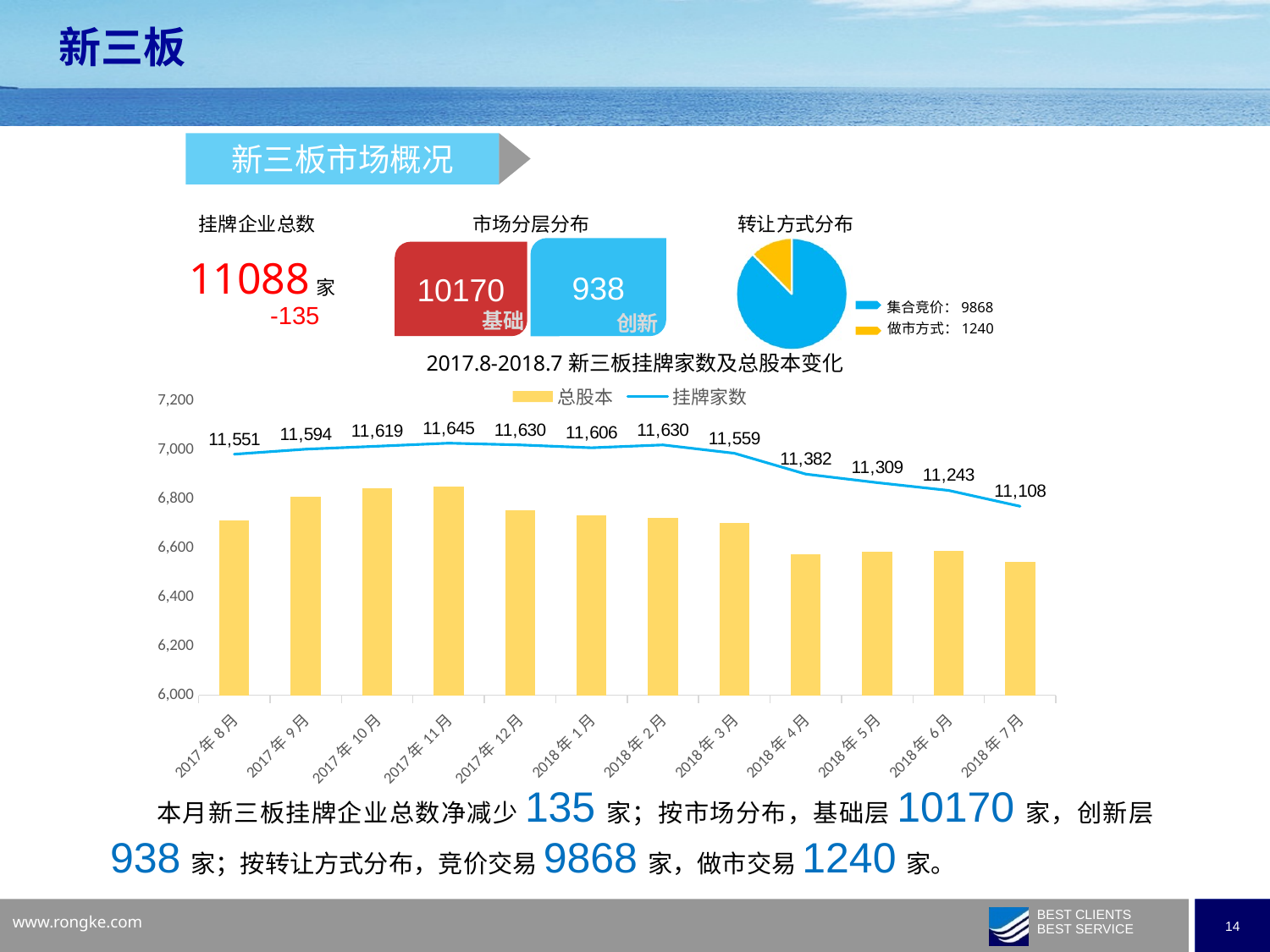
In the chart titled 2017.8-2018.7 新三板挂牌家数及总股本变化, is the 总股本 bar for 2017年11月 greater or less than 6,800? greater In the chart titled 2017.8-2018.7 新三板挂牌家数及总股本变化, how many months are shown on the x axis? 12 In the pie chart titled 转让方式分布, what is the value for 做市方式? 1240 In the chart titled 2017.8-2018.7 新三板挂牌家数及总股本变化, which month has the lowest 挂牌家数? 2018年7月 In the chart titled 2017.8-2018.7 新三板挂牌家数及总股本变化, does the 挂牌家数 line rise or fall from 2018年2月 to 2018年7月? fall In the chart titled 2017.8-2018.7 新三板挂牌家数及总股本变化, how many series does the legend list? 2 In the chart titled 2017.8-2018.7 新三板挂牌家数及总股本变化, what is the 挂牌家数 value for 2017年11月? 11,645 In the chart titled 2017.8-2018.7 新三板挂牌家数及总股本变化, what is the difference between the 挂牌家数 for 2017年11月 and 2018年7月? 537 In the chart titled 2017.8-2018.7 新三板挂牌家数及总股本变化, which is larger, the 挂牌家数 for 2018年3月 or for 2018年4月? 2018年3月 In the chart titled 2017.8-2018.7 新三板挂牌家数及总股本变化, what is the 挂牌家数 value for 2018年7月? 11,108 In the chart titled 2017.8-2018.7 新三板挂牌家数及总股本变化, is the 总股本 bar for 2018年4月 greater or less than 6,600? less In the chart titled 2017.8-2018.7 新三板挂牌家数及总股本变化, which month has the highest 挂牌家数? 2017年11月